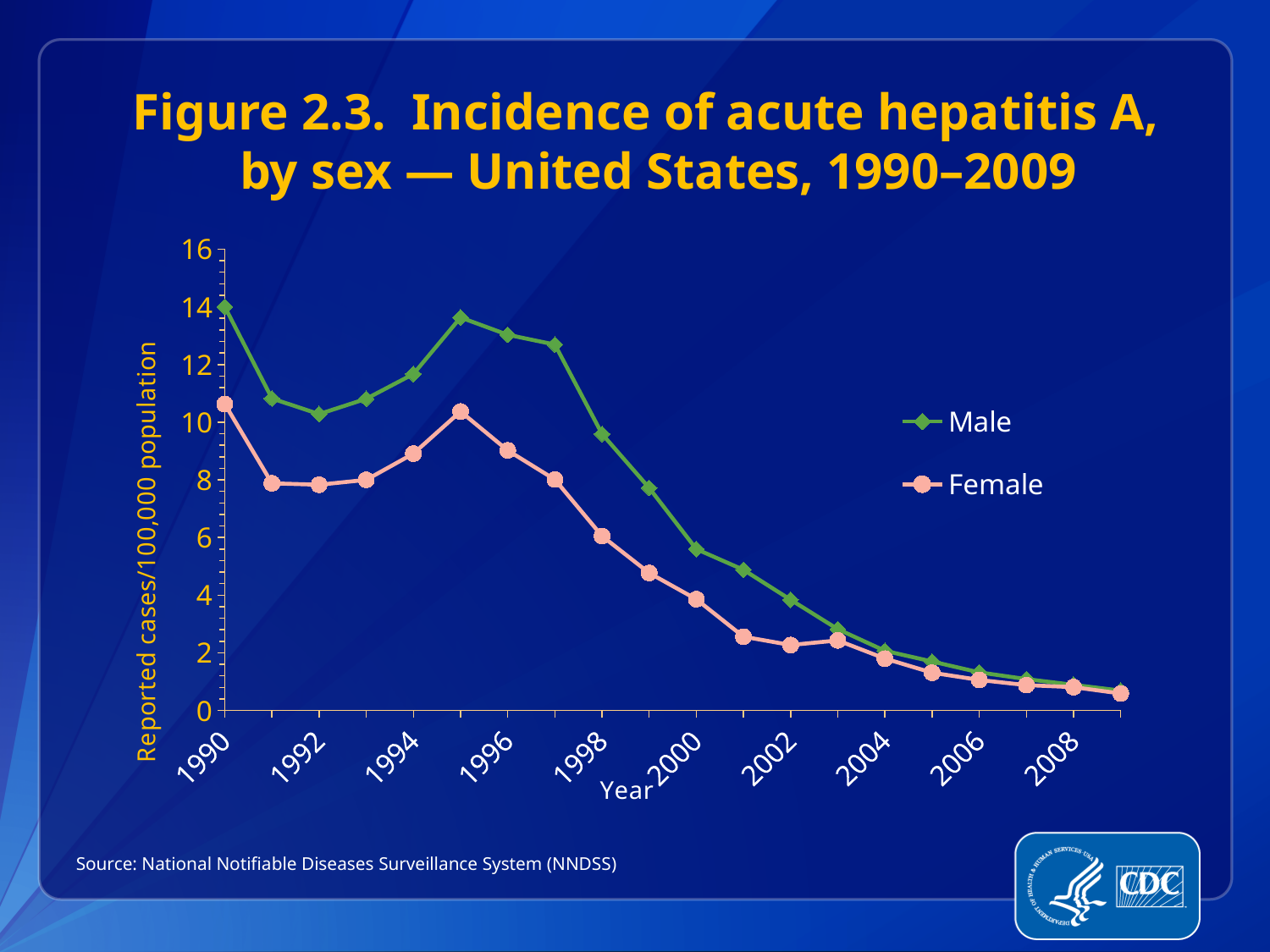
What is the label on the y axis? Reported cases/100,000 population Is the Female value for 1992 greater or less than 10? less How many years (data points) are plotted for each series? 20 How many series does the legend list? 2 In which year is the Male series at its lowest value? 2009 Is the Male value for 2009 greater or less than 2? less Is the Male value for 1998 greater or less than 8? greater Do the values for both series rise or fall from 1997 to 2009? fall What kind of chart is shown on the slide? line chart In 1996, which series has the higher value, Male or Female? Male